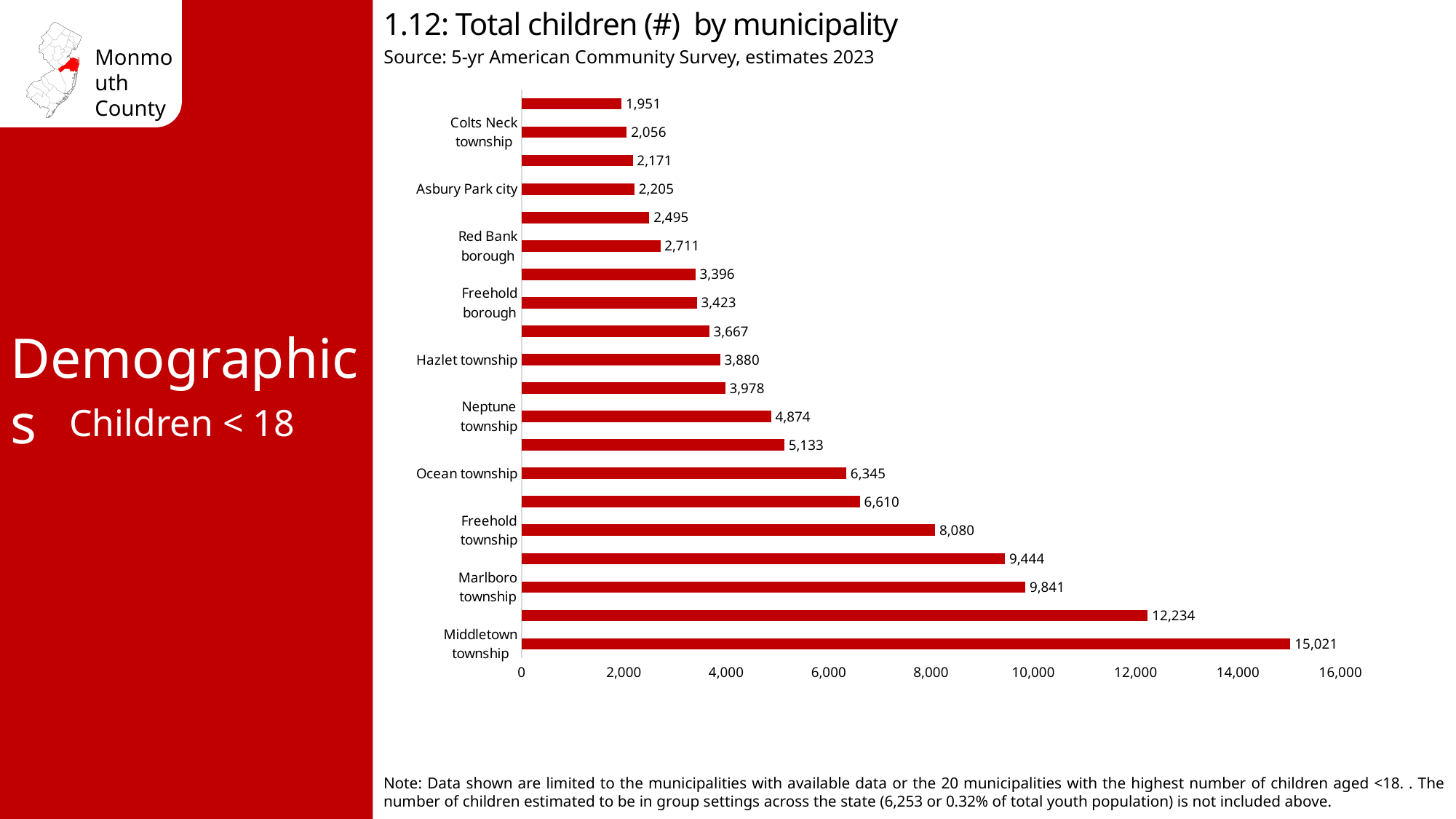
Is the value for Middletown township greater or less than 14,000? greater How many bars are shown on the chart? 20 What is the value for Middletown township? 15,021 Which is larger, the value for Ocean township or the value for Neptune township? Ocean township What is the title of the chart? 1.12: Total children (#) by municipality Which municipality has the highest number of children? Middletown township What is the value for Neptune township? 4,874 What is the value for Marlboro township? 9,841 What is the smallest value shown on the chart? 1,951 What kind of chart is shown on the slide? bar chart What is the value for Asbury Park city? 2,205 What is the difference between the values for Middletown township and Marlboro township? 5,180